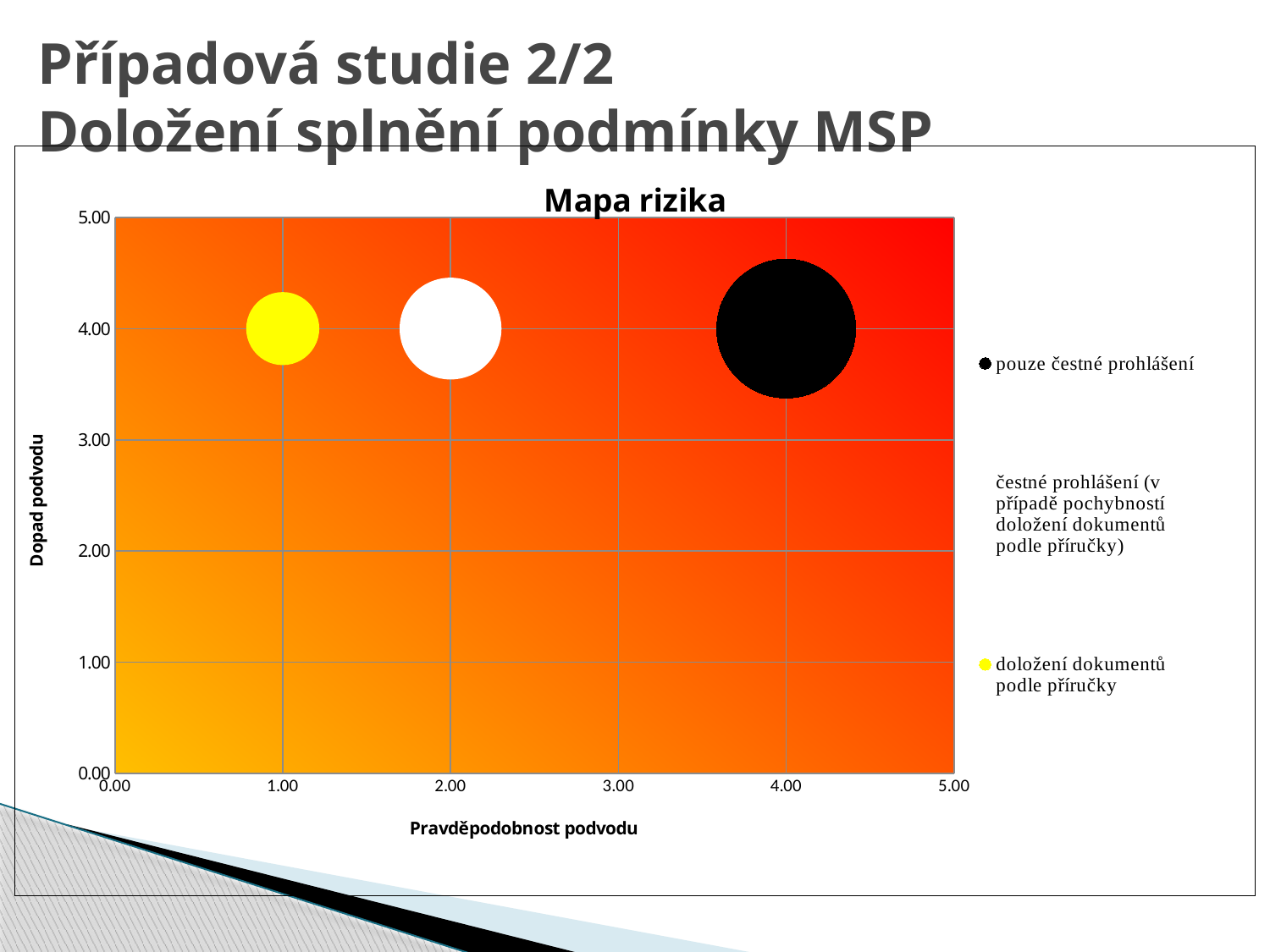
What is the title of the chart? Mapa rizika What is the x-axis value (Pravděpodobnost podvodu) for the series 'pouze čestné prohlášení'? 4.00 Is the Pravděpodobnost podvodu value for 'pouze čestné prohlášení' greater or less than 3.00? greater Which series has the lowest value on the Pravděpodobnost podvodu axis? doložení dokumentů podle příručky What kind of chart is shown on the slide? Bubble chart Which series has the highest value on the Pravděpodobnost podvodu axis? pouze čestné prohlášení What is the y-axis value (Dopad podvodu) for the series 'pouze čestné prohlášení'? 4.00 What is the title of the horizontal axis? Pravděpodobnost podvodu What is the x-axis value (Pravděpodobnost podvodu) for the series 'doložení dokumentů podle příručky'? 1.00 How many series does the chart legend list? 3 How many bubbles are plotted on the chart? 3 What is the difference in Pravděpodobnost podvodu between 'pouze čestné prohlášení' and 'doložení dokumentů podle příručky'? 3.00